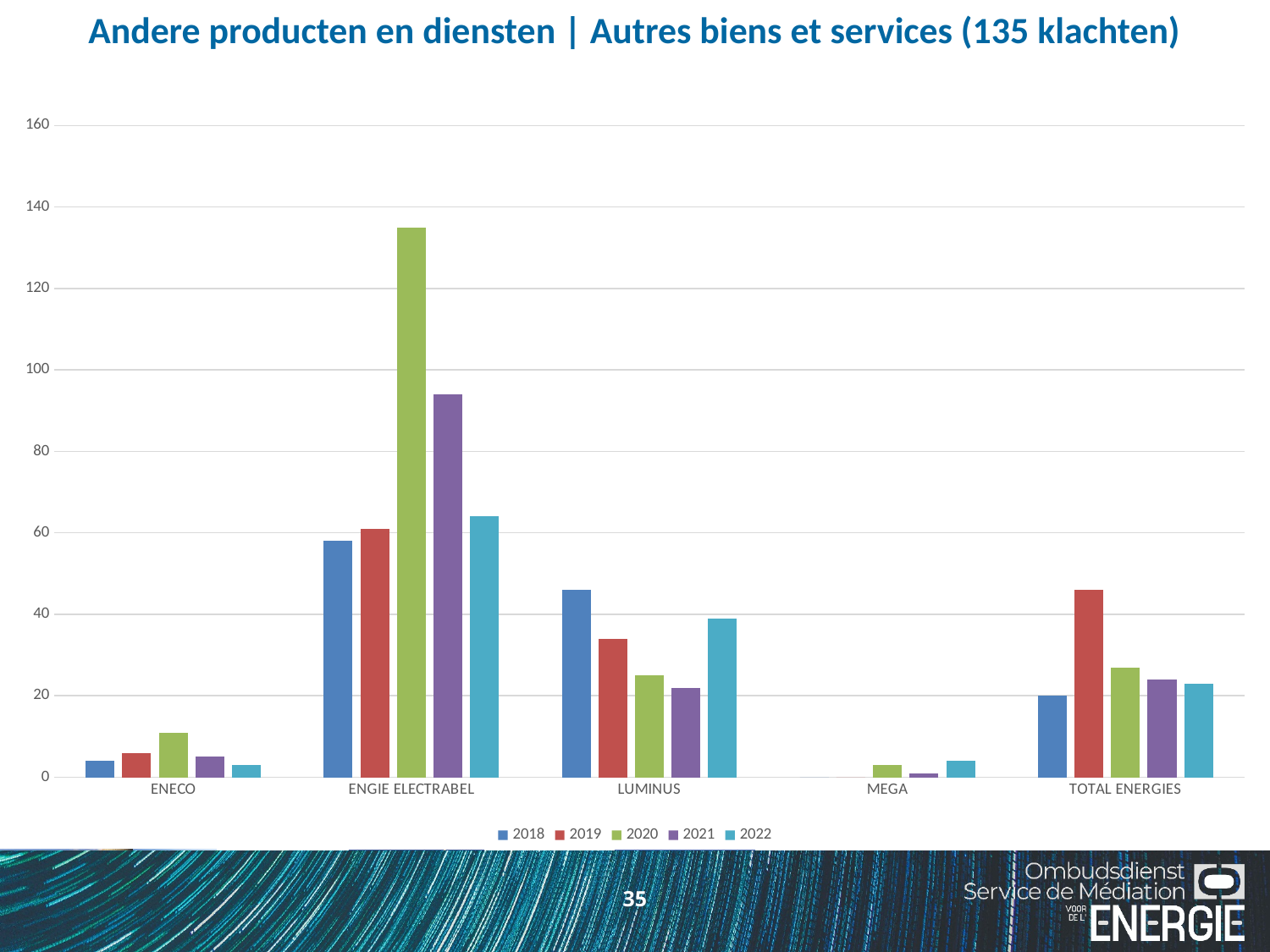
For LUMINUS, which is larger: the 2018 value or the 2019 value? 2018 How many series does the legend list? 5 For ENGIE ELECTRABEL, which year has the highest value? 2020 Is the 2021 value for ENGIE ELECTRABEL greater or less than 100? less For ENGIE ELECTRABEL, do the values rise or fall from 2020 to 2022? fall Is the 2019 value for TOTAL ENERGIES greater or less than 40? greater What is the title of the chart? Andere producten en diensten | Autres biens et services (135 klachten) Is the 2020 value for ENGIE ELECTRABEL greater or less than 120? greater What kind of chart is shown on the slide? bar chart How many supplier categories are shown on the x axis? 5 For TOTAL ENERGIES, which year has the highest value? 2019